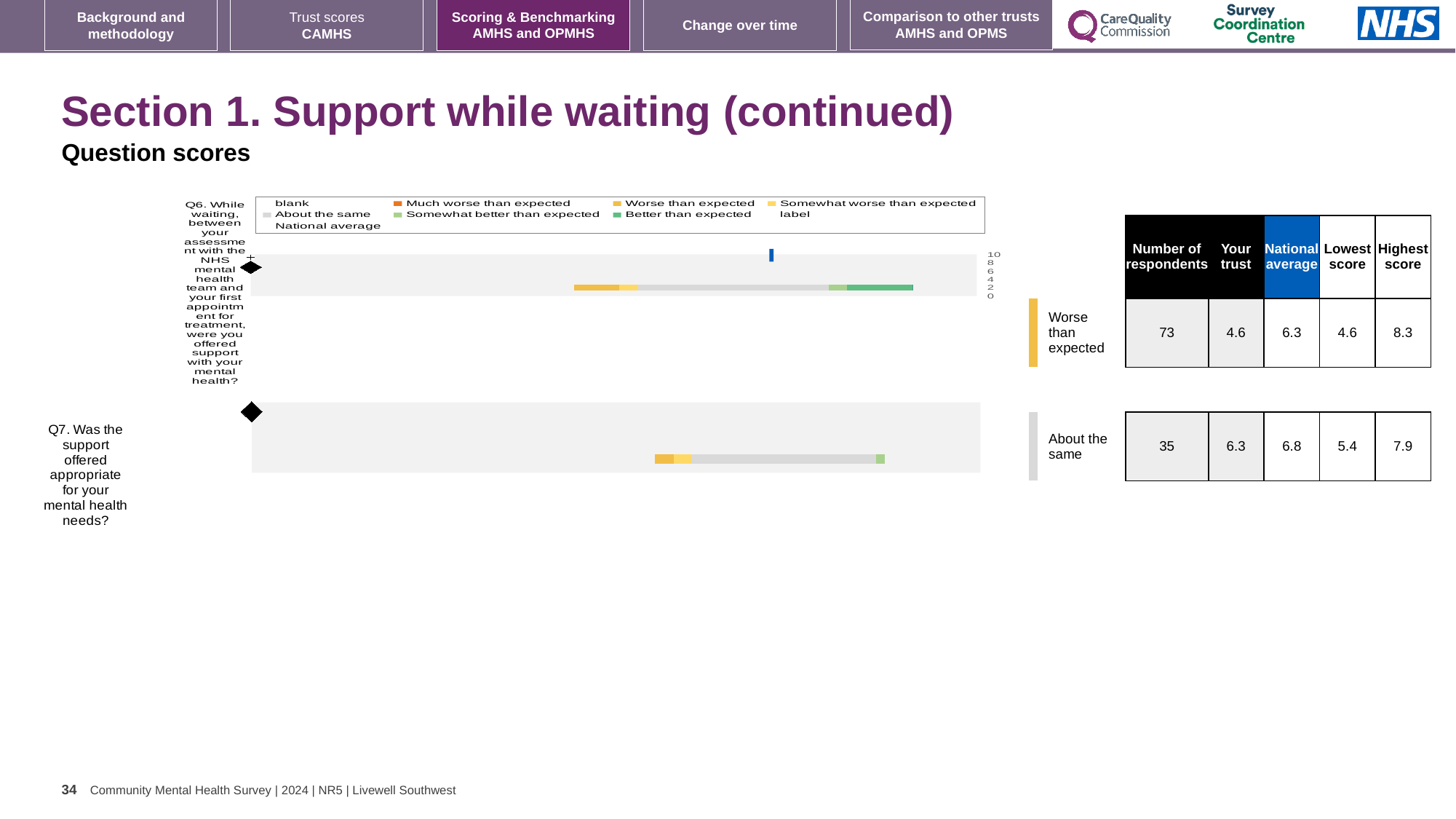
Which question had more respondents, Q6 or Q7? Q6 How many questions are plotted in the chart? 2 Which benchmark category is Q6 placed in? Worse than expected For Q7, which is larger: the 'Your trust' score or the national average? National average What kind of chart is used to show the question scores on this slide? bar chart What is the difference between the highest score and the lowest score for Q6? 3.7 How many respondents answered Q7? 35 What is the national average score for Q6? 6.3 Which benchmark category is Q7 placed in? About the same How many respondents answered Q6? 73 What is the highest score for Q7? 7.9 What is the 'Your trust' score for Q6? 4.6